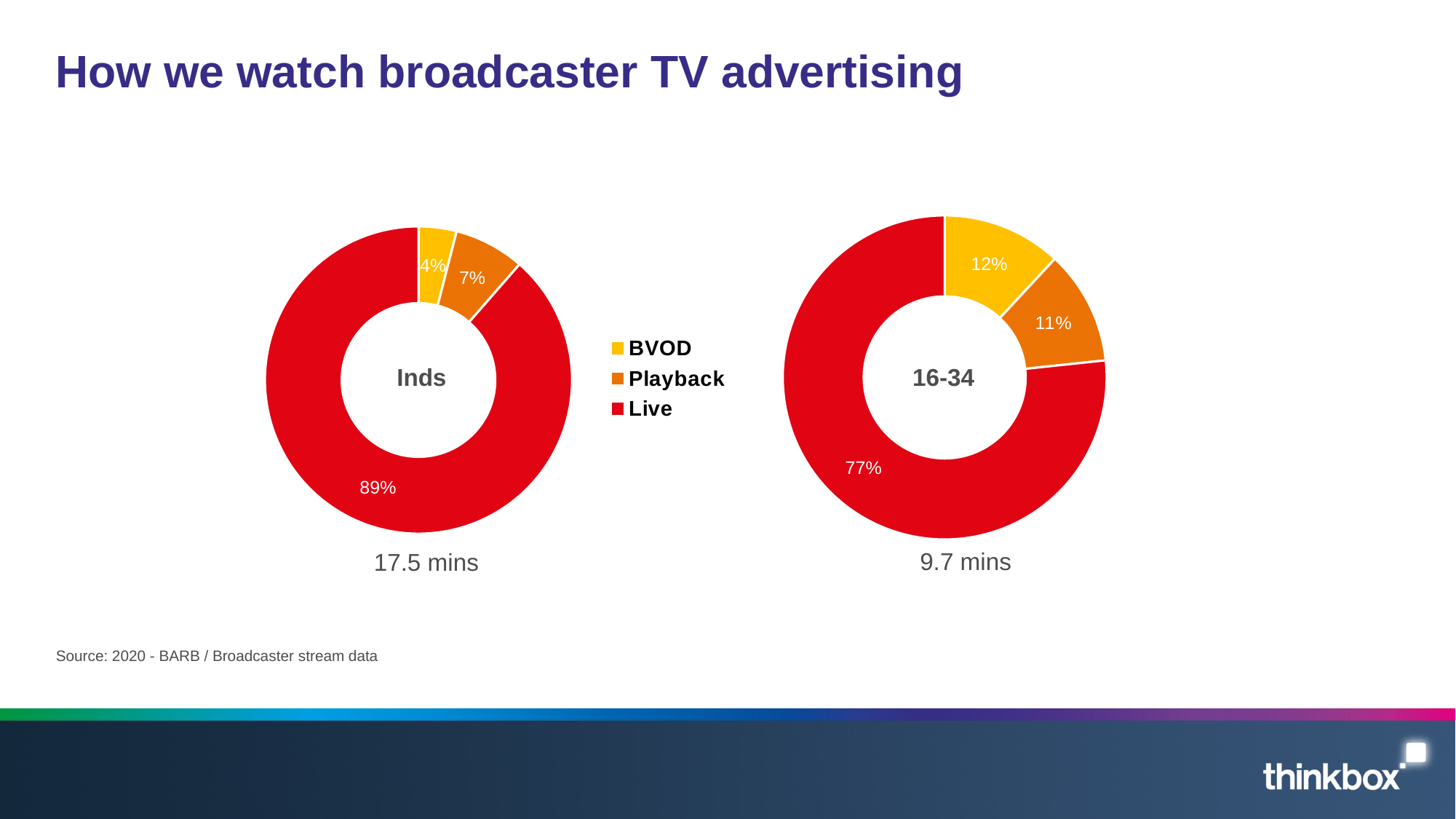
What is the average minutes figure shown below the Inds chart? 17.5 mins In the Inds chart, which category has the smallest share? BVOD What kind of chart is used on this slide? Doughnut (pie) chart Which is larger: the BVOD share in the Inds chart or the BVOD share in the 16-34 chart? 16-34 What is the difference between the Live share in the Inds chart and the Live share in the 16-34 chart? 12 percentage points In the 16-34 chart, which category has the largest share? Live In the Inds chart, what share of viewing is Playback? 7% Which colour represents Playback in the legend? Orange In the 16-34 chart, what share of viewing is BVOD? 12% In the Inds chart, what share of broadcaster TV advertising viewing is Live? 89% In the 16-34 chart, what share of viewing is Playback? 11% How many categories does the legend list? 3